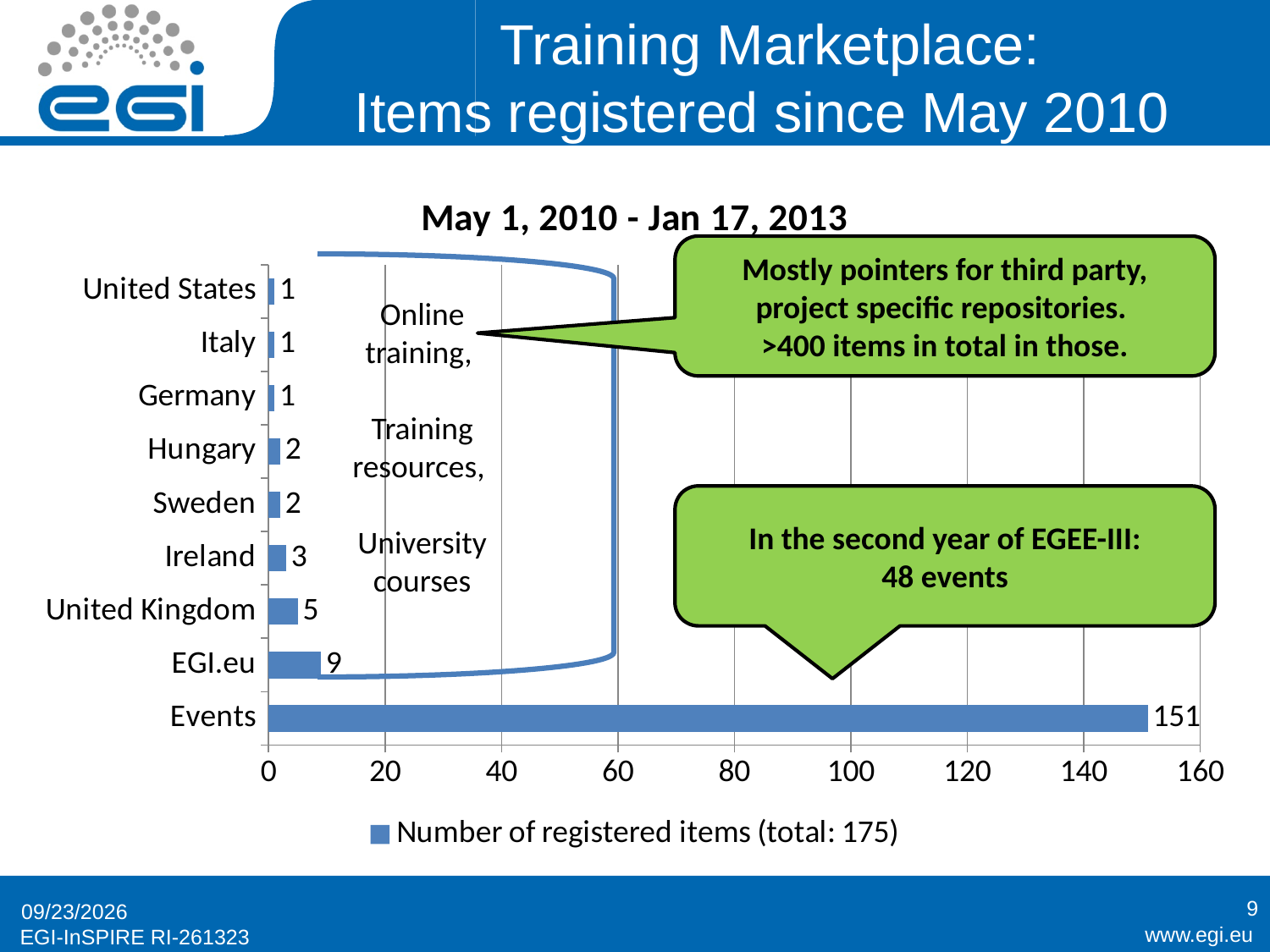
How many categories are shown on the chart? 9 What is the value for Ireland? 3 Is the value for Events greater or less than 140? greater What kind of chart is shown? bar chart What is the title of the chart? May 1, 2010 - Jan 17, 2013 What is the difference between the values for Events and EGI.eu? 142 What is the value for Events? 151 Which is larger, the value for United Kingdom or the value for Hungary? United Kingdom How many series does the legend list? 1 What is the value for United Kingdom? 5 What is the value for EGI.eu? 9 Which category has the highest value? Events